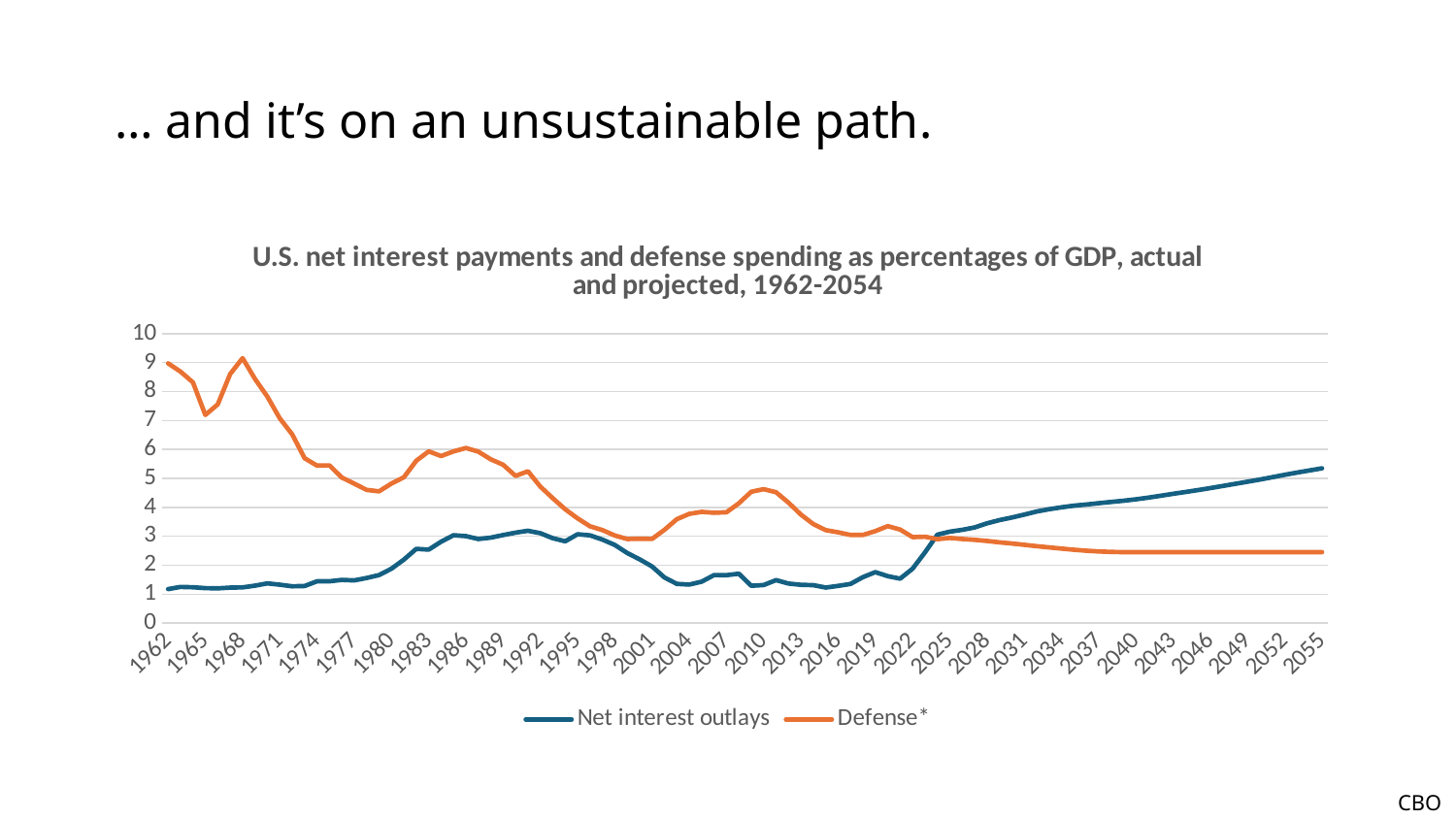
Is the value for Defense* in 1962 greater or less than 8? greater Is the value for Net interest outlays in 2055 greater or less than 4? greater Is the value for Net interest outlays in 2004 greater or less than 2? less Which series is drawn in orange? Defense* How many series does the legend list? 2 What kind of chart is shown on the slide? Line chart Does the Net interest outlays line rise or fall from 2025 to 2055? Rise What is the title of the chart? U.S. net interest payments and defense spending as percentages of GDP, actual and projected, 1962-2054 In 1962, which series has the larger value, Net interest outlays or Defense*? Defense* In 2055, which series has the larger value, Net interest outlays or Defense*? Net interest outlays